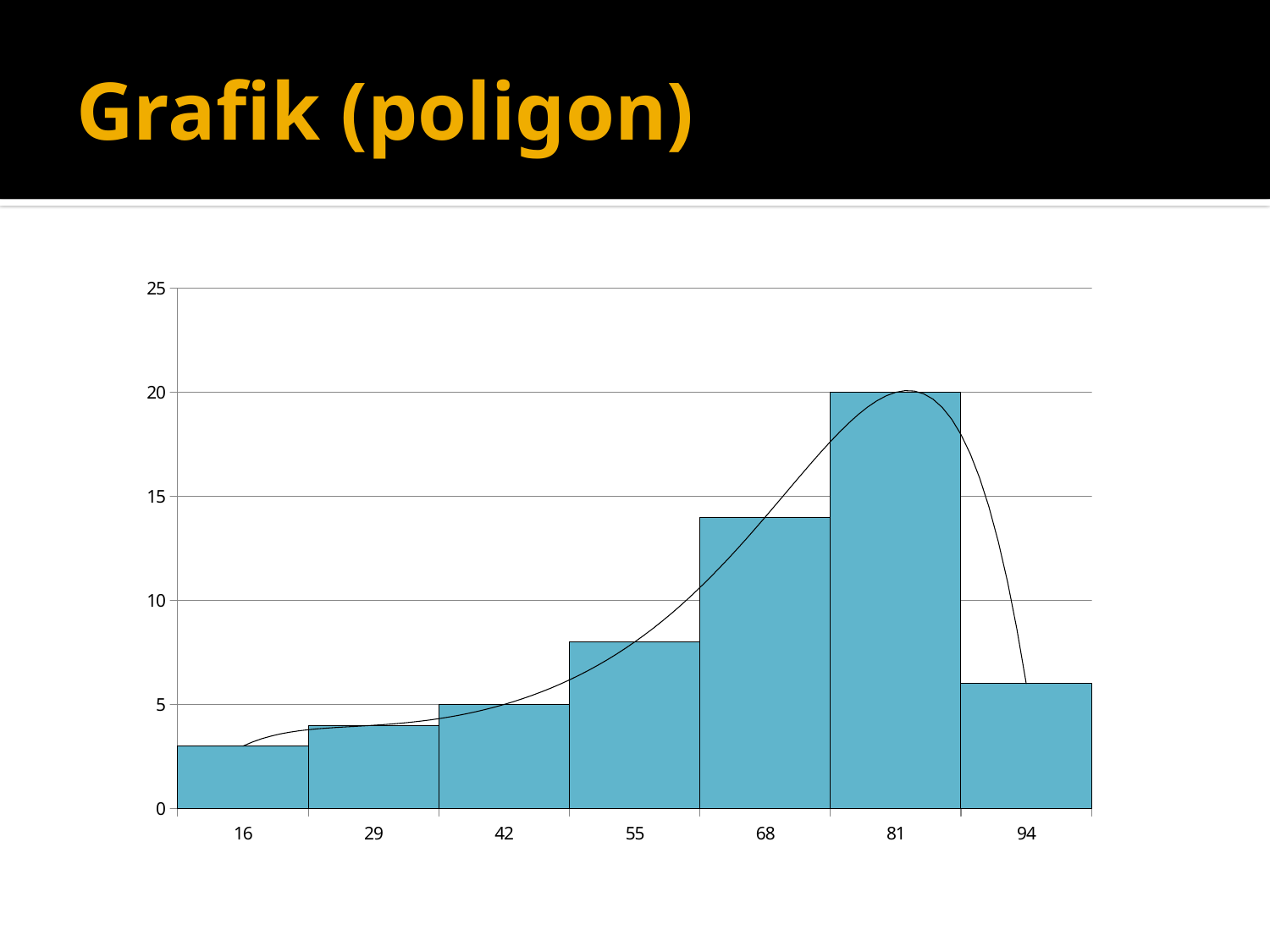
What kind of chart is shown on the slide? bar chart Is the value for 55 greater or less than 5? greater Which category has the lowest bar? 16 What is the value of the bar at 81? 20 Which category has the highest bar? 81 Do the bar values rise or fall from 16 to 81? rise How many bars are shown in the chart? 7 Is the value for 68 greater or less than 10? greater Is the value for 94 greater or less than 10? less Which bar is taller, 68 or 94? 68 What is the value of the bar at 42? 5